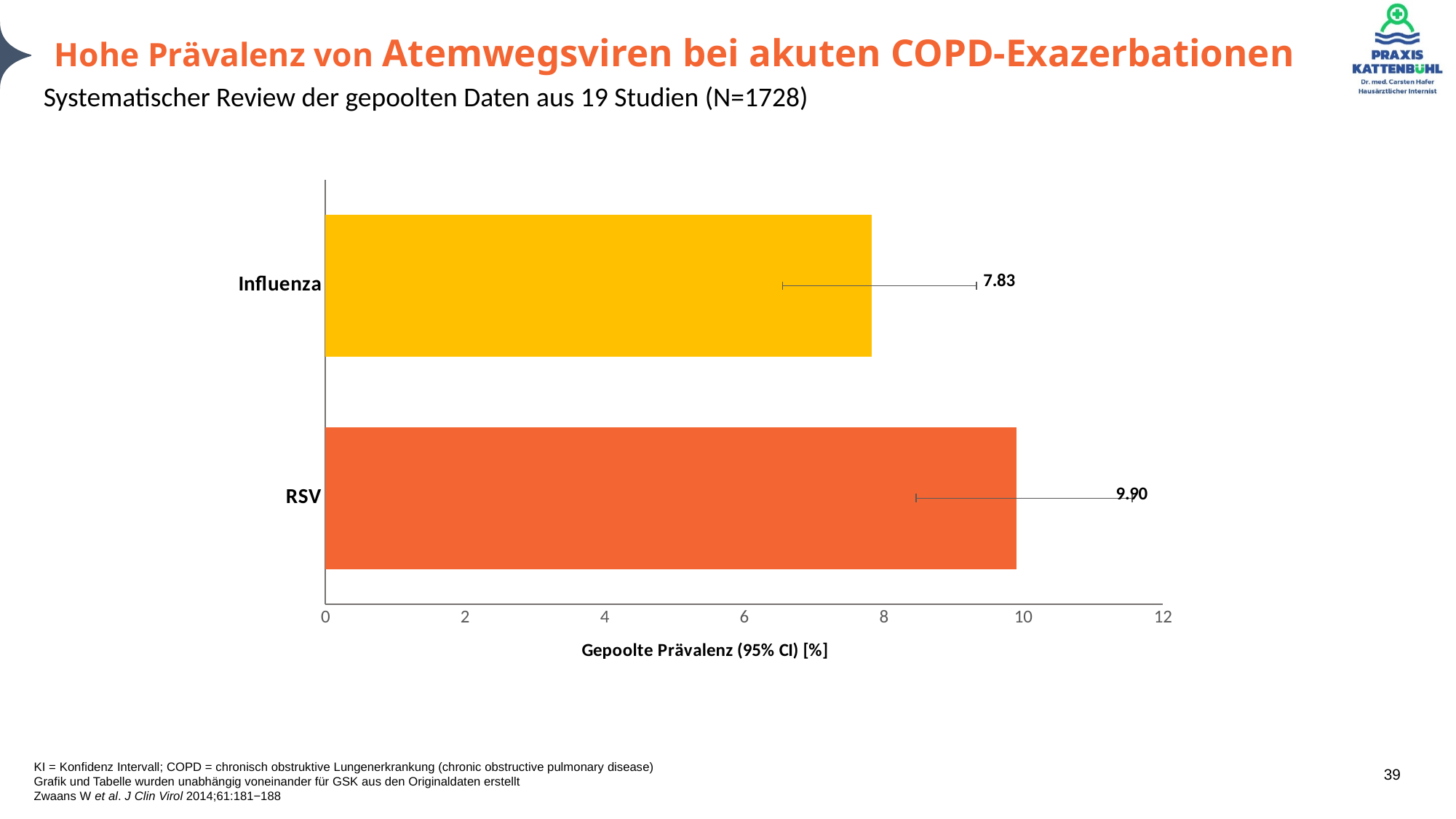
What kind of chart is shown on the slide? bar chart Which category has the lower pooled prevalence? Influenza What is the difference between the RSV and Influenza pooled prevalence values? 2.07 What is the pooled prevalence value shown for Influenza? 7.83 How many categories are plotted in the chart? 2 What is the pooled prevalence value shown for RSV? 9.90 What is the label of the x axis? Gepoolte Prävalenz (95% CI) [%] Which category has the higher pooled prevalence, Influenza or RSV? RSV What is the maximum value shown on the x axis? 12 What colour is the bar for RSV? orange Is the value for Influenza greater or less than 8? less Is the value for RSV greater or less than 8? greater